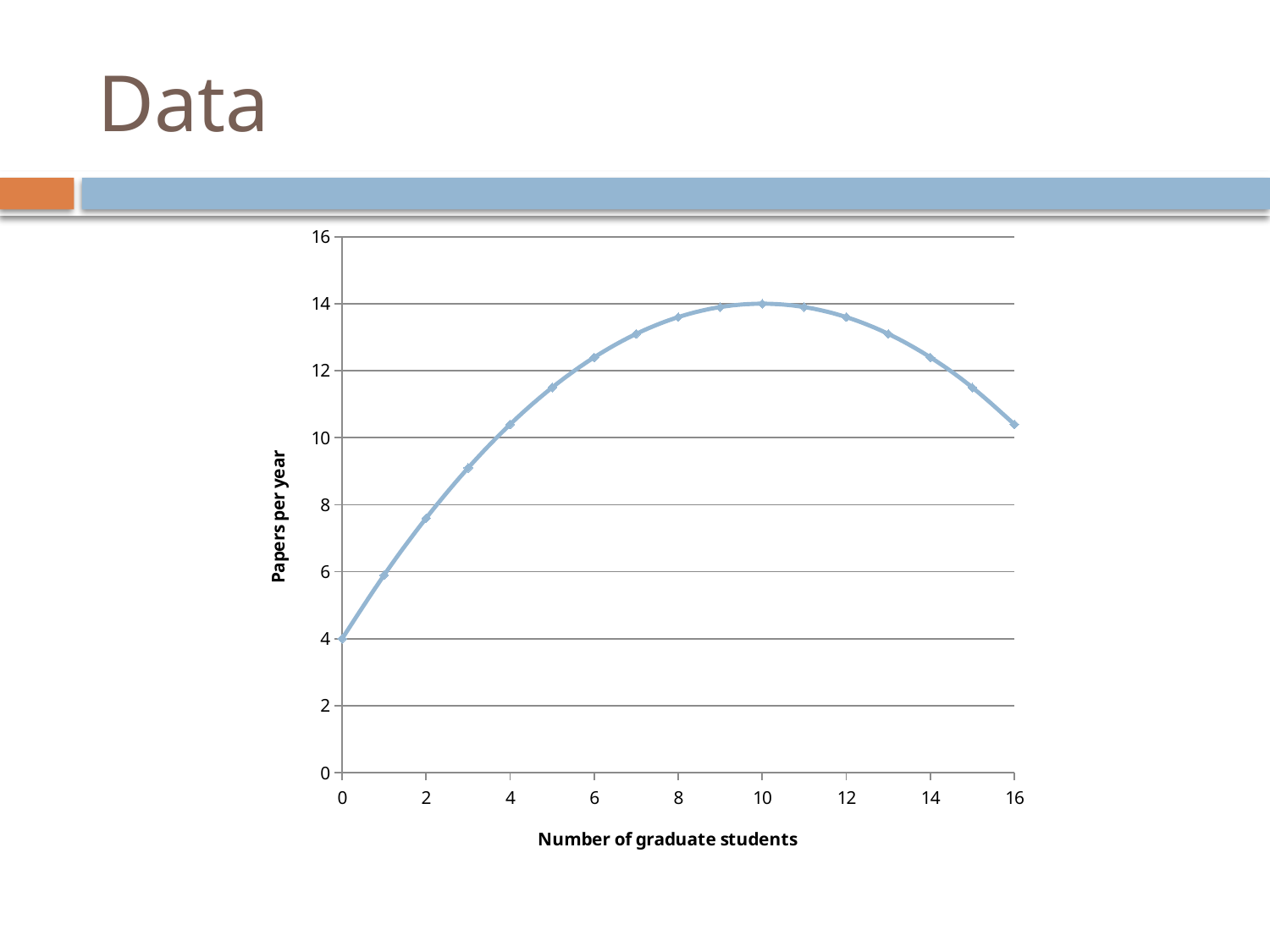
How do papers per year change as the number of graduate students increases from 0 to 16? rise until 10, then fall What kind of chart is shown on the slide? line chart Is the value for 2 graduate students greater or less than 8 papers per year? less At which number of graduate students is papers per year lowest? 0 What is the value of papers per year when the number of graduate students is 10? 14 Is the value for 14 graduate students greater or less than 12 papers per year? greater What is the title of the vertical axis? Papers per year At which number of graduate students is papers per year highest? 10 What is the value of papers per year when the number of graduate students is 0? 4 What is the difference in papers per year between 10 graduate students and 0 graduate students? 10 How many data points are plotted on the line? 17 Which has more papers per year: 4 graduate students or 12 graduate students? 12 graduate students